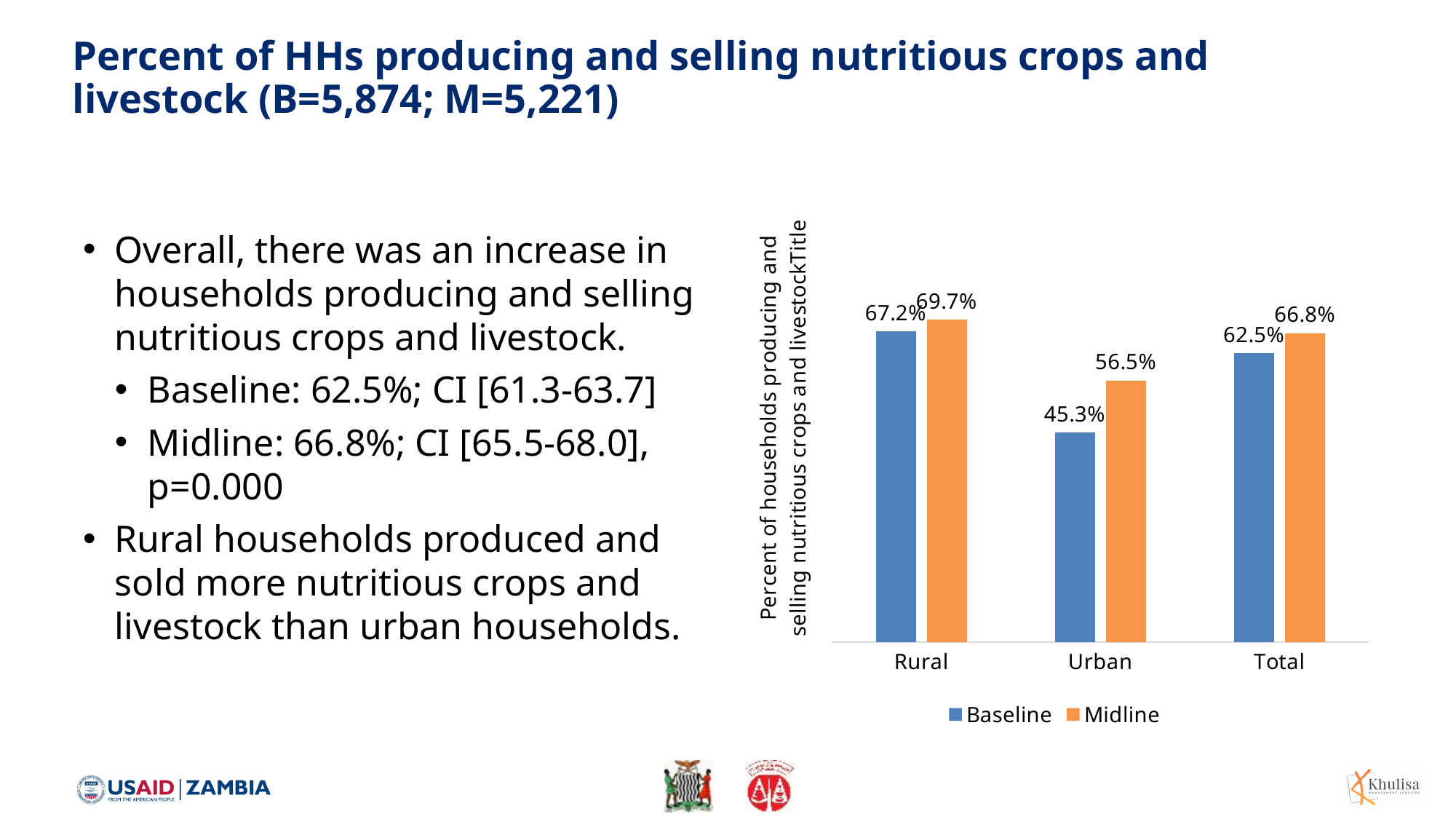
What is the Midline value for Total? 66.8% How many series does the legend list? 2 What is the difference between the Rural and Urban Midline values? 13.2% What is the Baseline value for Urban households? 45.3% How many categories are shown on the x axis? 3 What is the Baseline value for Rural households? 67.2% Which category has the lowest Baseline value? Urban What is the Midline value for Urban households? 56.5% Which category has the highest Midline value? Rural What is the difference between the Midline and Baseline values for Urban households? 11.2% What kind of chart is shown on the slide? Bar chart Which is larger, the Baseline value for Rural or the Midline value for Total? Baseline value for Rural